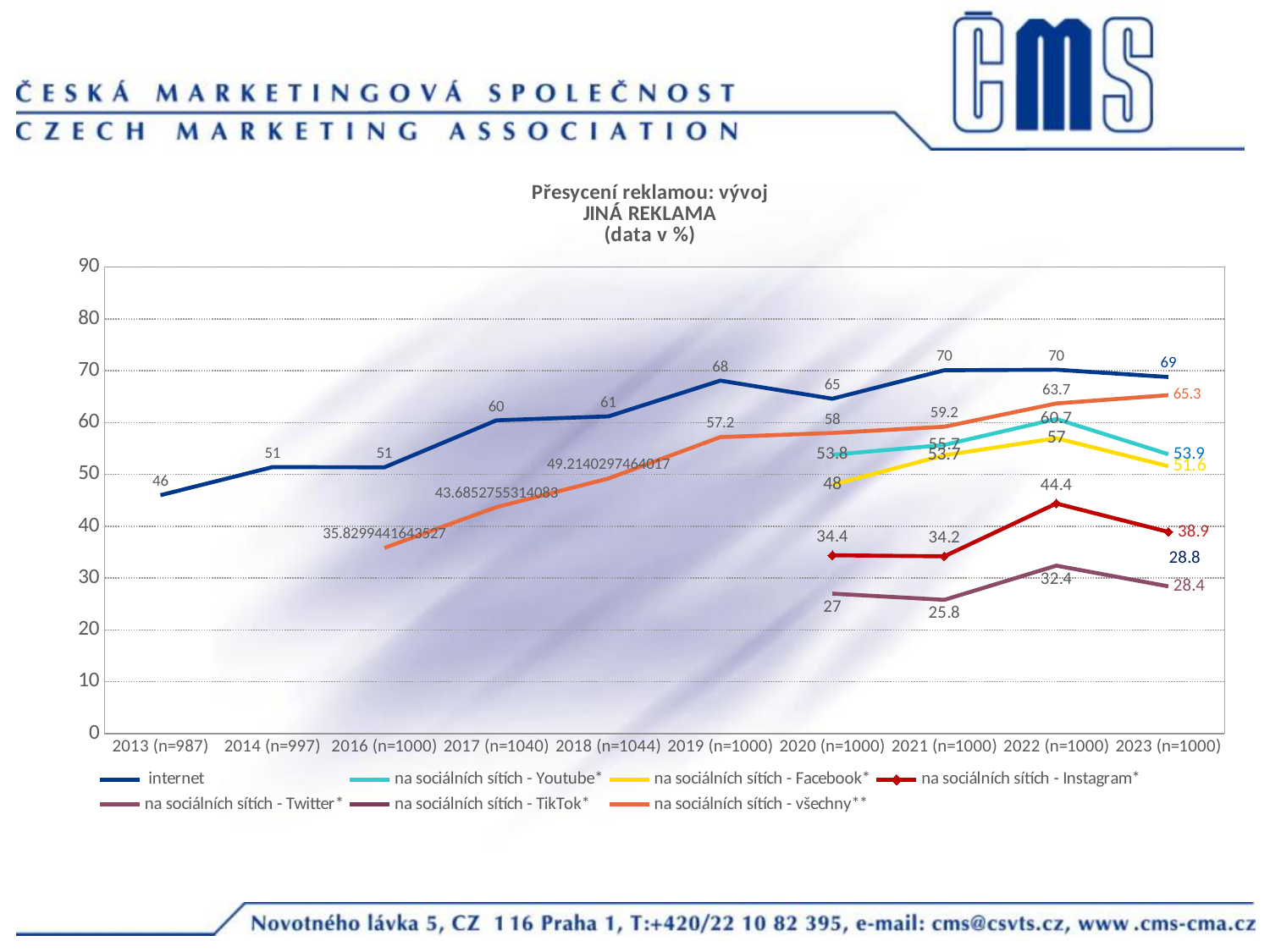
What is the value for internet in 2023 (n=1000)? 69 What is the difference between the internet value in 2023 (n=1000) and in 2013 (n=987)? 23 In which year is the value for na sociálních sítích - Instagram* highest? 2022 (n=1000) What is the value for na sociálních sítích - TikTok* in 2023 (n=1000)? 28.8 How many series does the legend list? 7 Does the internet series rise or fall from 2013 (n=987) to 2019 (n=1000)? rise What is the value for internet in 2013 (n=987)? 46 How many years (categories) are shown on the x axis? 10 What kind of chart is shown on the slide? line chart In 2022 (n=1000), which is larger: na sociálních sítích - Youtube* or na sociálních sítích - Facebook*? na sociálních sítích - Youtube* What is the value for na sociálních sítích - všechny** in 2023 (n=1000)? 65.3 In which year is the value for na sociálních sítích - Twitter* lowest? 2021 (n=1000)